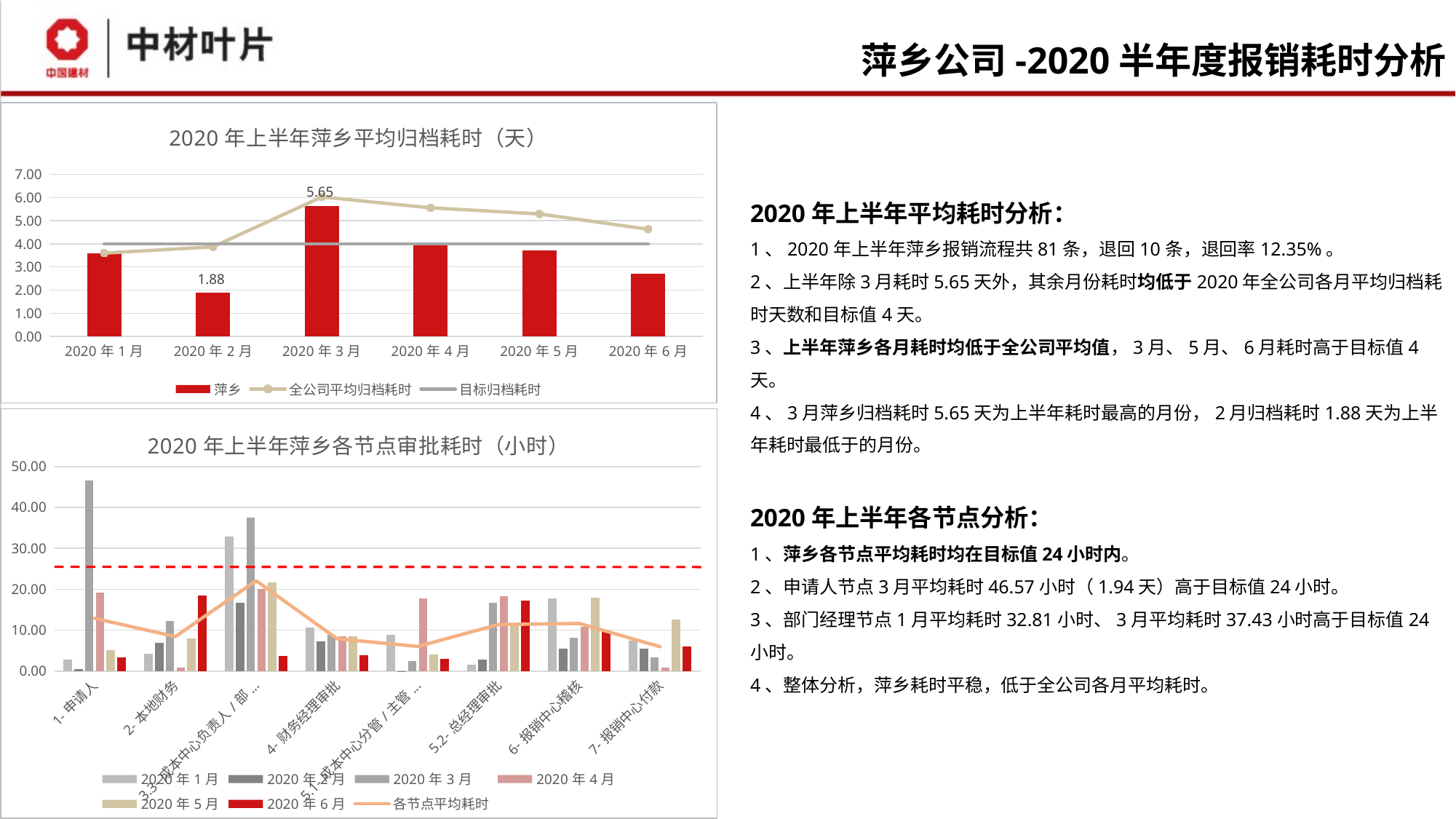
In the top chart (2020年上半年萍乡平均归档耗时), does the 全公司平均归档耗时 line rise or fall from 2020年3月 to 2020年6月? fall In the bottom chart (2020年上半年萍乡各节点审批耗时), is the 2020年3月 value for 1-申请人 greater or less than 40.00? greater In the bottom chart (2020年上半年萍乡各节点审批耗时), how many node categories are shown on the x axis? 8 In the top chart (2020年上半年萍乡平均归档耗时), which month has the lowest 萍乡 value? 2020年2月 In the top chart (2020年上半年萍乡平均归档耗时), which month has the highest 萍乡 value? 2020年3月 In the bottom chart (2020年上半年萍乡各节点审批耗时), how many series does the legend list? 7 In the top chart (2020年上半年萍乡平均归档耗时), what is the value for 萍乡 in 2020年3月? 5.65 In the top chart (2020年上半年萍乡平均归档耗时), is the 萍乡 value for 2020年1月 greater or less than 4.00? less In the top chart (2020年上半年萍乡平均归档耗时), what is the value for 萍乡 in 2020年2月? 1.88 In the top chart (2020年上半年萍乡平均归档耗时), what is the difference between the 萍乡 values for 2020年3月 and 2020年2月? 3.77 In the top chart (2020年上半年萍乡平均归档耗时), how many series does the legend list? 3 In the top chart (2020年上半年萍乡平均归档耗时), how many months are shown on the x axis? 6